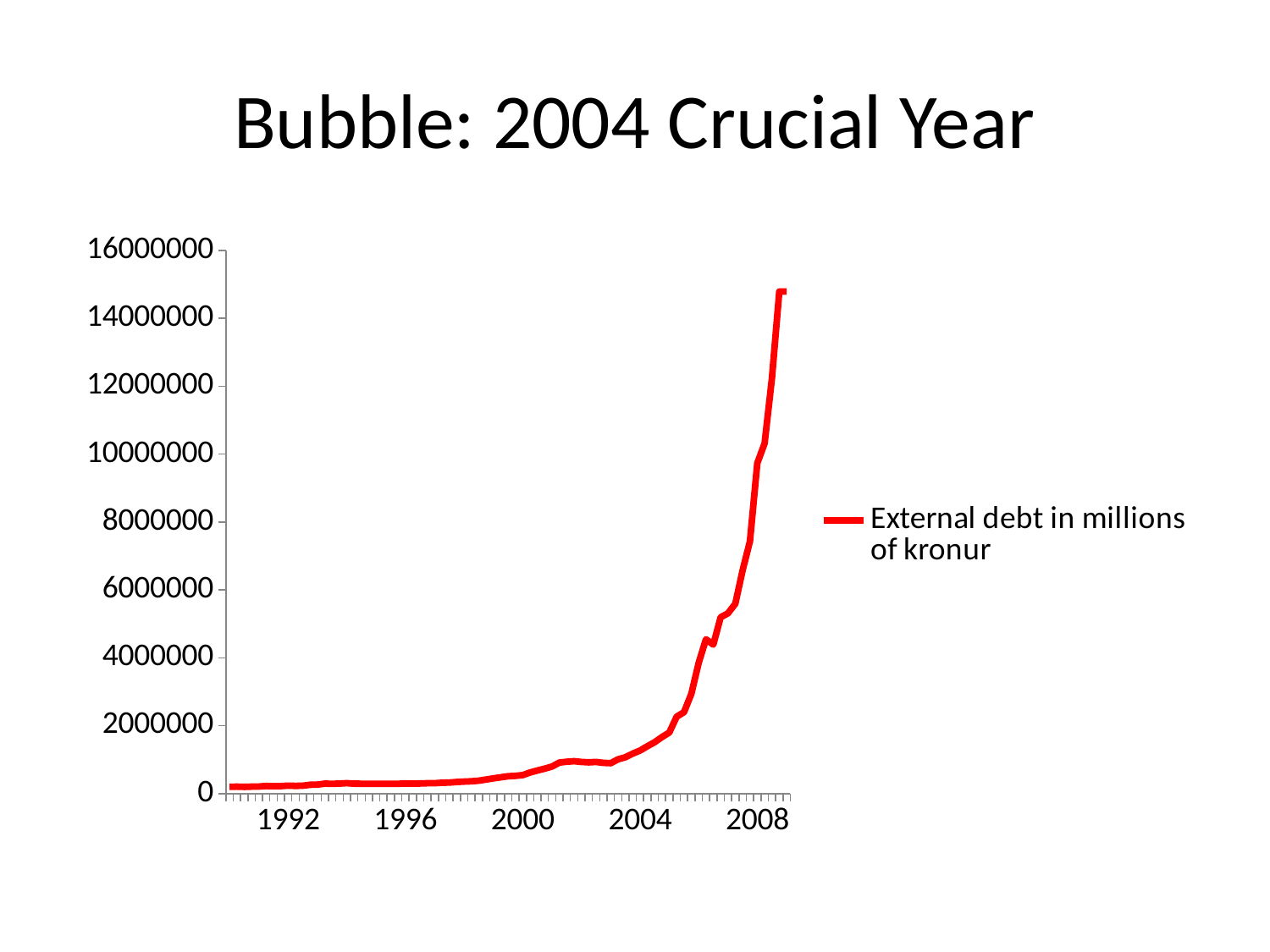
Is the value for external debt at 2004 greater or less than 2000000? less Is the value for external debt at 2008 greater or less than 8000000? greater Does the external debt generally rise or fall from 1992 to 2008? rise What is the series name shown in the legend? External debt in millions of kronur How many series does the legend list? 1 What kind of chart is shown on the slide? line chart Is the value for external debt at 2000 greater or less than 2000000? less What is the title of the slide containing the chart? Bubble: 2004 Crucial Year What is the highest value labelled on the vertical axis? 16000000 Is the highest external debt value at the beginning or the end of the series? end Which is larger, the external debt at 2000 or at 2008? 2008